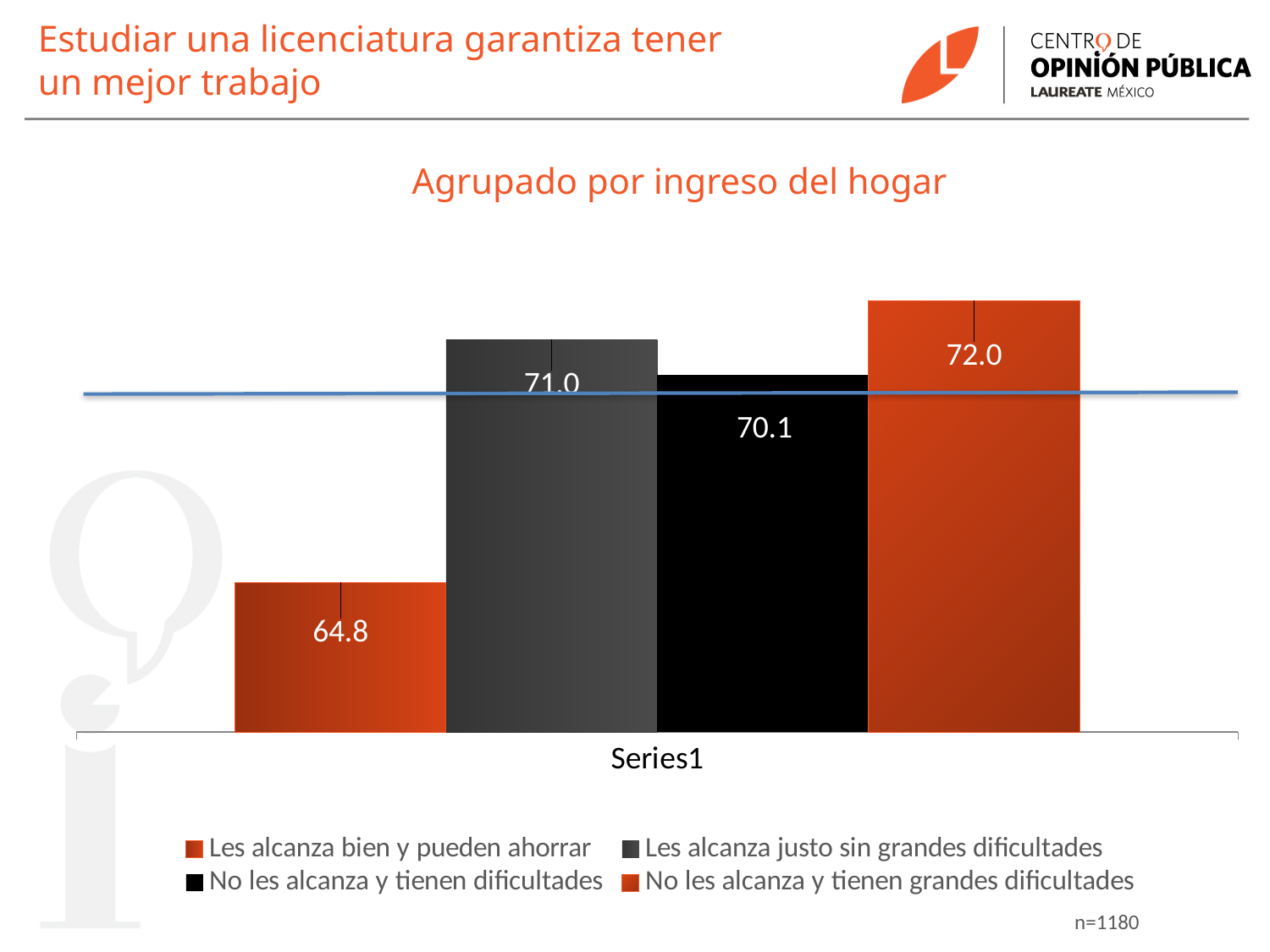
How many series does the legend list? 4 Which group has the lowest value? Les alcanza bien y pueden ahorrar What is the value for "Les alcanza justo sin grandes dificultades"? 71.0 Which is larger: the value for "Les alcanza justo sin grandes dificultades" or the value for "No les alcanza y tienen dificultades"? Les alcanza justo sin grandes dificultades How many bars are plotted in the chart? 4 Which group has the highest value? No les alcanza y tienen grandes dificultades What is the value for "No les alcanza y tienen grandes dificultades"? 72.0 What is the value for "No les alcanza y tienen dificultades"? 70.1 What is the difference between the values for "No les alcanza y tienen grandes dificultades" and "Les alcanza bien y pueden ahorrar"? 7.2 What is the value for "Les alcanza bien y pueden ahorrar"? 64.8 What is the title of the chart? Agrupado por ingreso del hogar What kind of chart is shown on the slide? Bar chart